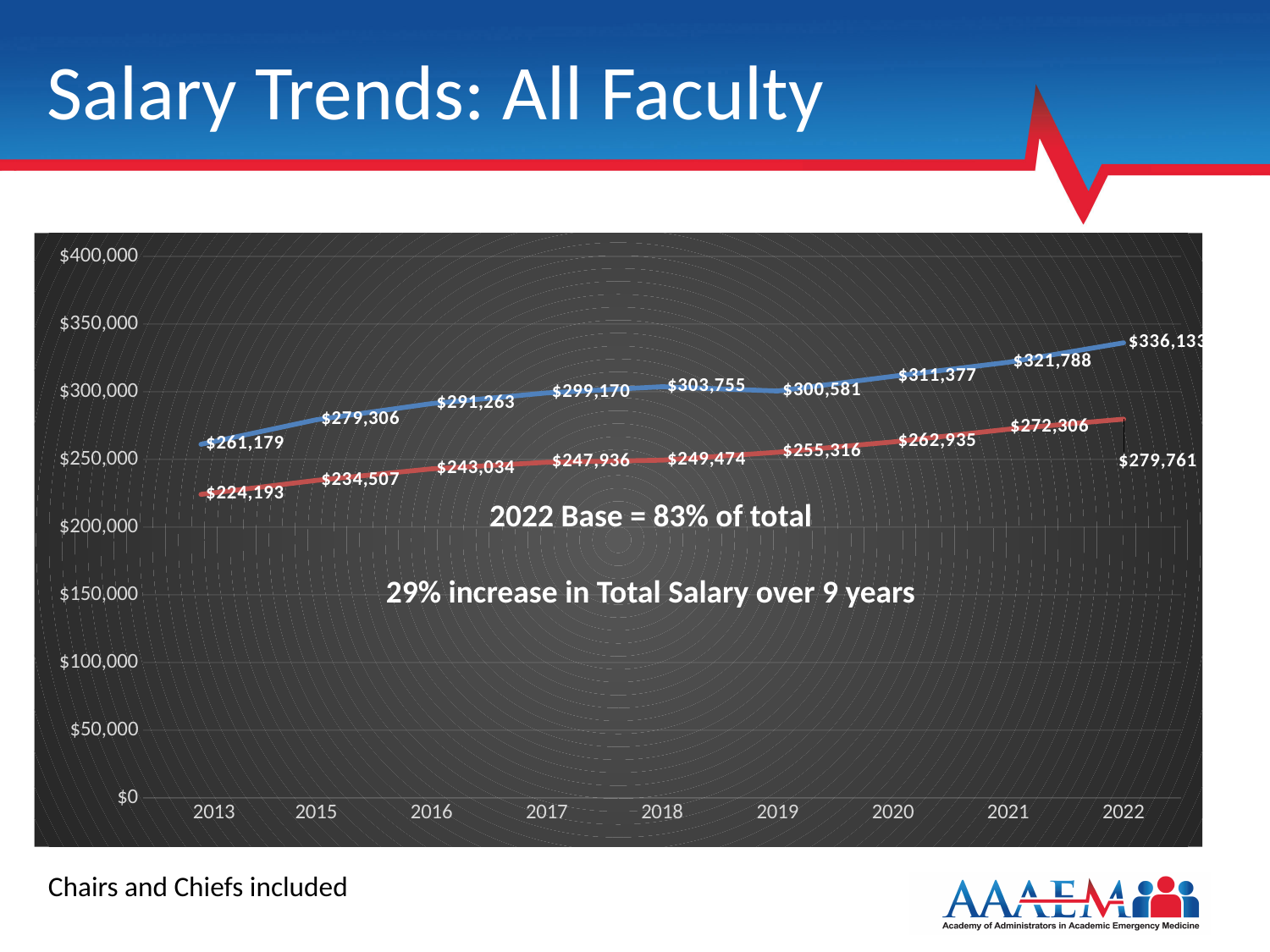
What is the value of the blue line in 2022? $336,133 What type of chart is shown on the slide? line chart What is the value of the red line in 2013? $224,193 What is the difference between the blue line and the red line in 2022? $56,372 In which year is the red line at its lowest value? 2013 In which year does the blue line reach its highest value? 2022 Does the red line generally rise or fall from 2013 to 2022? rise What is the title of the slide containing the chart? Salary Trends: All Faculty By how much did the blue line increase from 2013 to 2022? $74,954 What is the value of the blue line in 2019? $300,581 Which is larger, the blue line value in 2018 or the blue line value in 2019? 2018 How many years are plotted along the x axis? 9